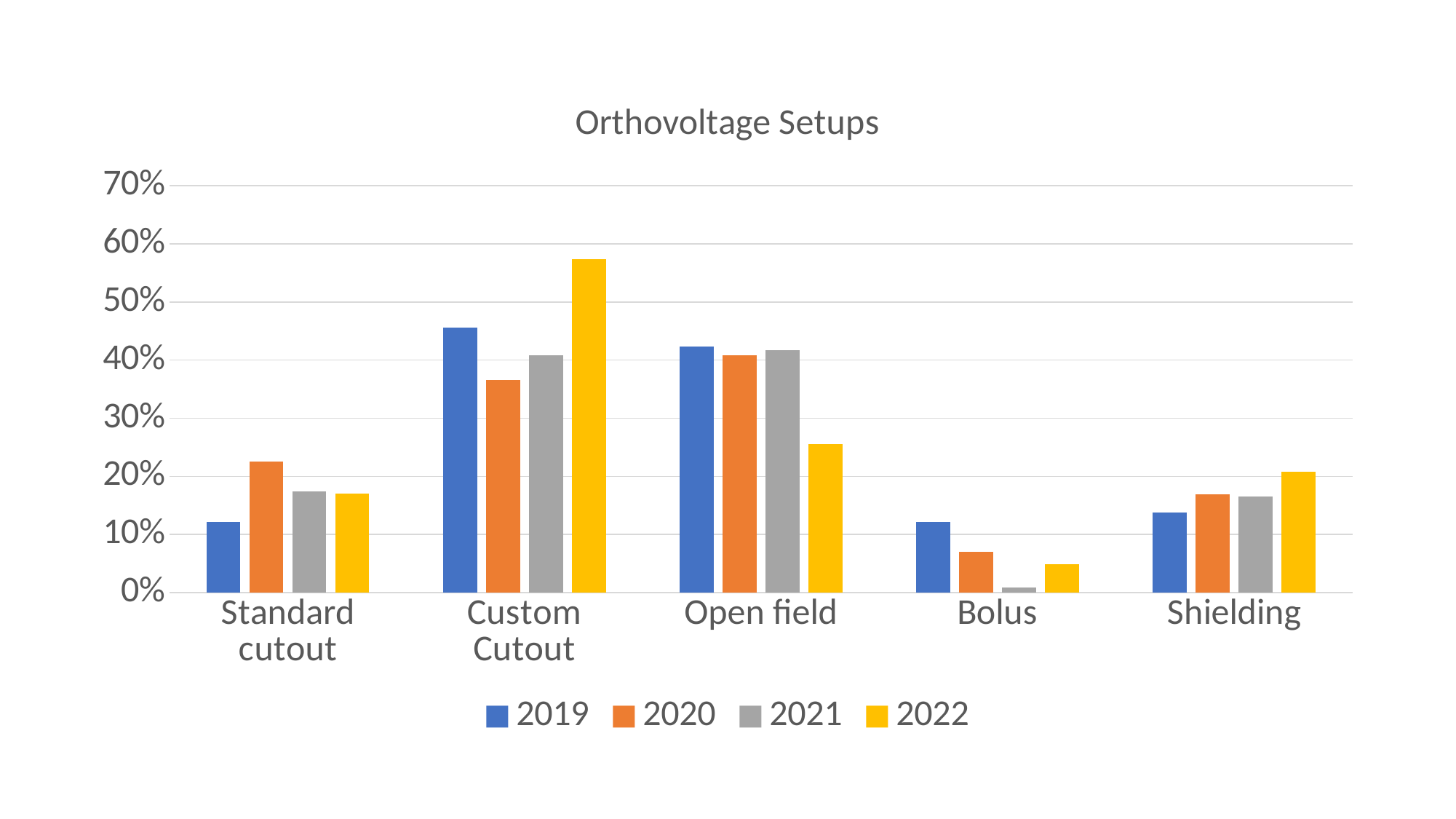
How many categories are shown on the x axis? 5 What is the title of the chart? Orthovoltage Setups For Standard cutout, which is larger: the 2019 value or the 2020 value? 2020 Is the value for Open field in 2022 greater or less than 30%? less How many series does the legend list? 4 Which category has the lowest bar for 2021? Bolus Is the value for Bolus in 2021 greater or less than 10%? less Is the value for Custom Cutout in 2022 greater or less than 50%? greater What kind of chart is shown on the slide? bar chart Which category has the highest bar for 2022? Custom Cutout For Custom Cutout, which is larger: the 2019 value or the 2020 value? 2019 Which year has the highest bar in the Bolus category? 2019